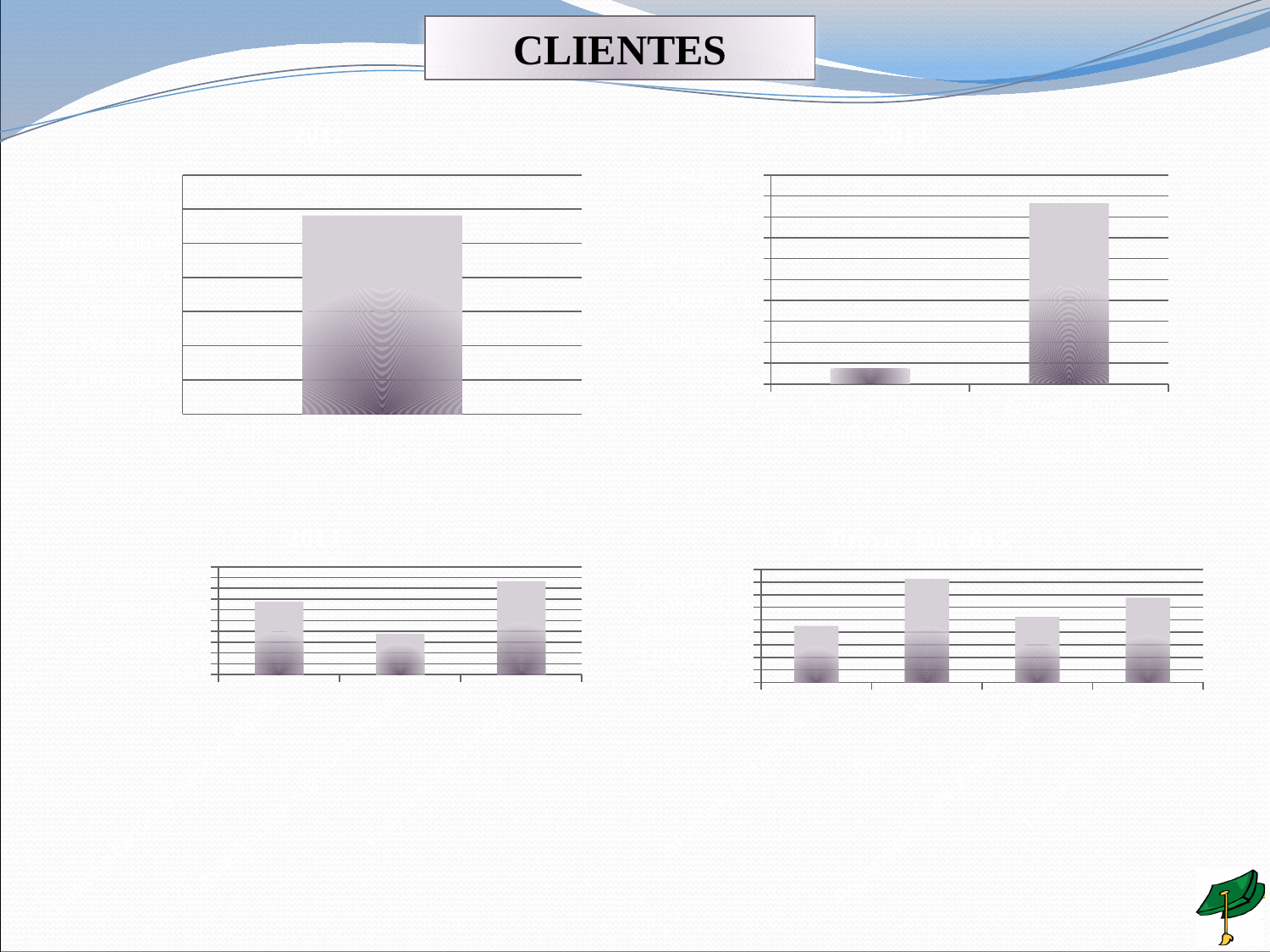
How many bars does the bottom-left chart show? 3 In the bottom-left chart, which bar is the tallest? the third (rightmost) bar In the top-right chart, which bar is taller, the left one or the right one? the right one How many bars does the top-right chart show? 2 In the bottom-left chart, which bar is the shortest? the second (middle) bar How many charts are shown on the slide? 4 In the bottom-right chart, which bar is the tallest? the second bar What kind of chart is the top-left chart on the slide? bar chart How many bars does the bottom-right chart show? 4 What is the title of the bottom-right chart? Proyección 2015 In the bottom-right chart, which bar is the shortest? the first (leftmost) bar